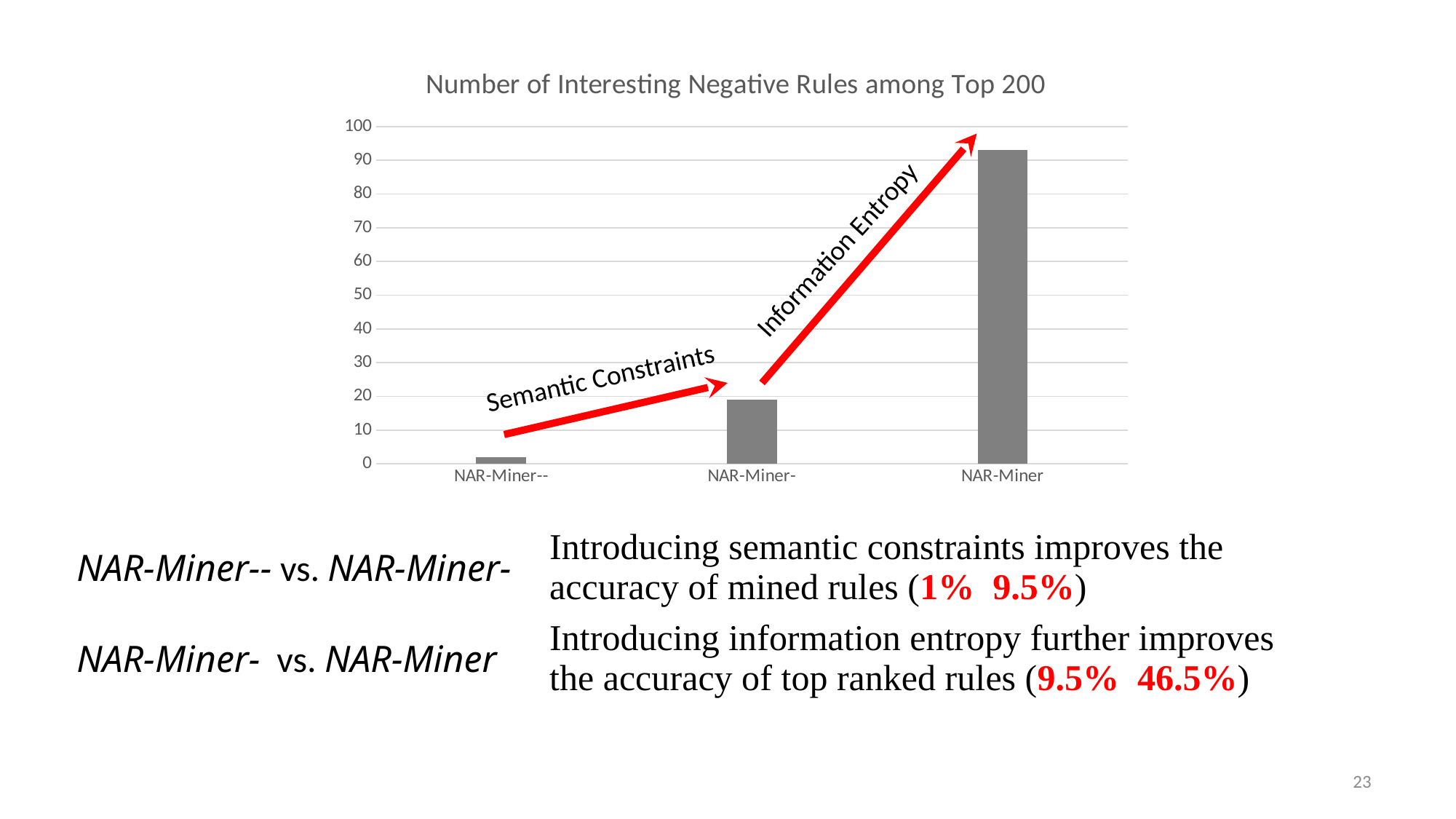
Which has a larger value, NAR-Miner- or NAR-Miner? NAR-Miner Is the value for NAR-Miner greater or less than 80? greater What label is written on the red arrow between the NAR-Miner- and NAR-Miner bars? Information Entropy Which category has the highest value in the chart? NAR-Miner Which has a larger value, NAR-Miner-- or NAR-Miner-? NAR-Miner- What kind of chart is shown on the slide? bar chart Do the values rise or fall from NAR-Miner-- to NAR-Miner along the x axis? rise How many categories are plotted in the chart? 3 What is the title of the chart? Number of Interesting Negative Rules among Top 200 Is the value for NAR-Miner- greater or less than 30? less Which category has the lowest value in the chart? NAR-Miner-- Is the value for NAR-Miner-- greater or less than 10? less